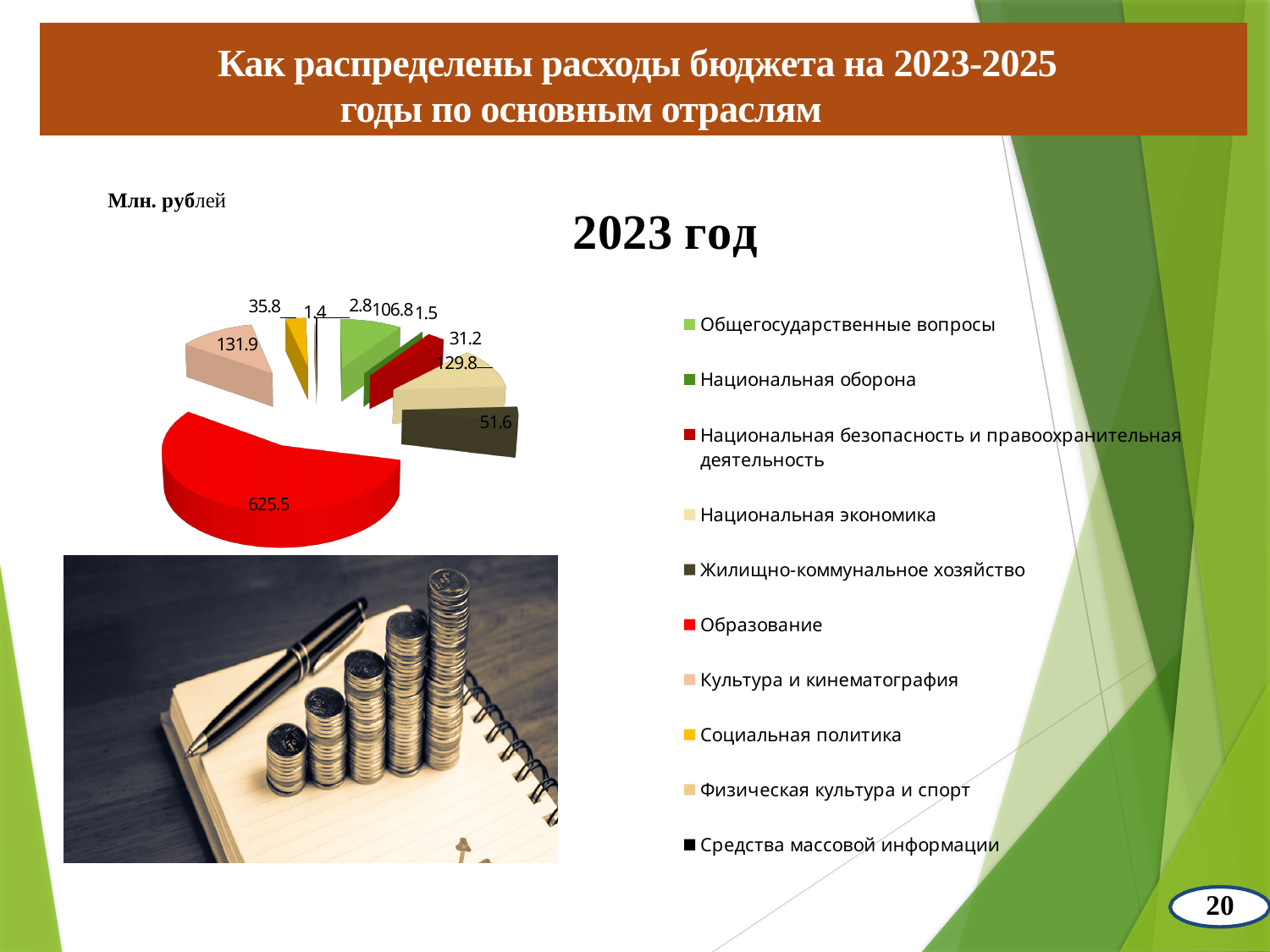
What is the value for Образование in the pie chart? 625.5 Which is larger, the value for Общегосударственные вопросы or for Жилищно-коммунальное хозяйство? Общегосударственные вопросы Which category has the largest slice of the pie? Образование How many categories does the legend of the pie chart list? 10 In what units are the values of the chart given, according to the slide? Млн. рублей What is the value for Жилищно-коммунальное хозяйство? 51.6 What is the value for Национальная экономика? 129.8 What is the smallest value labelled on the pie chart? 1.4 What is the value for Общегосударственные вопросы? 106.8 What is the value for Культура и кинематография? 131.9 What is the difference between the values for Образование and Культура и кинематография? 493.6 What kind of chart is shown on the slide? Pie chart